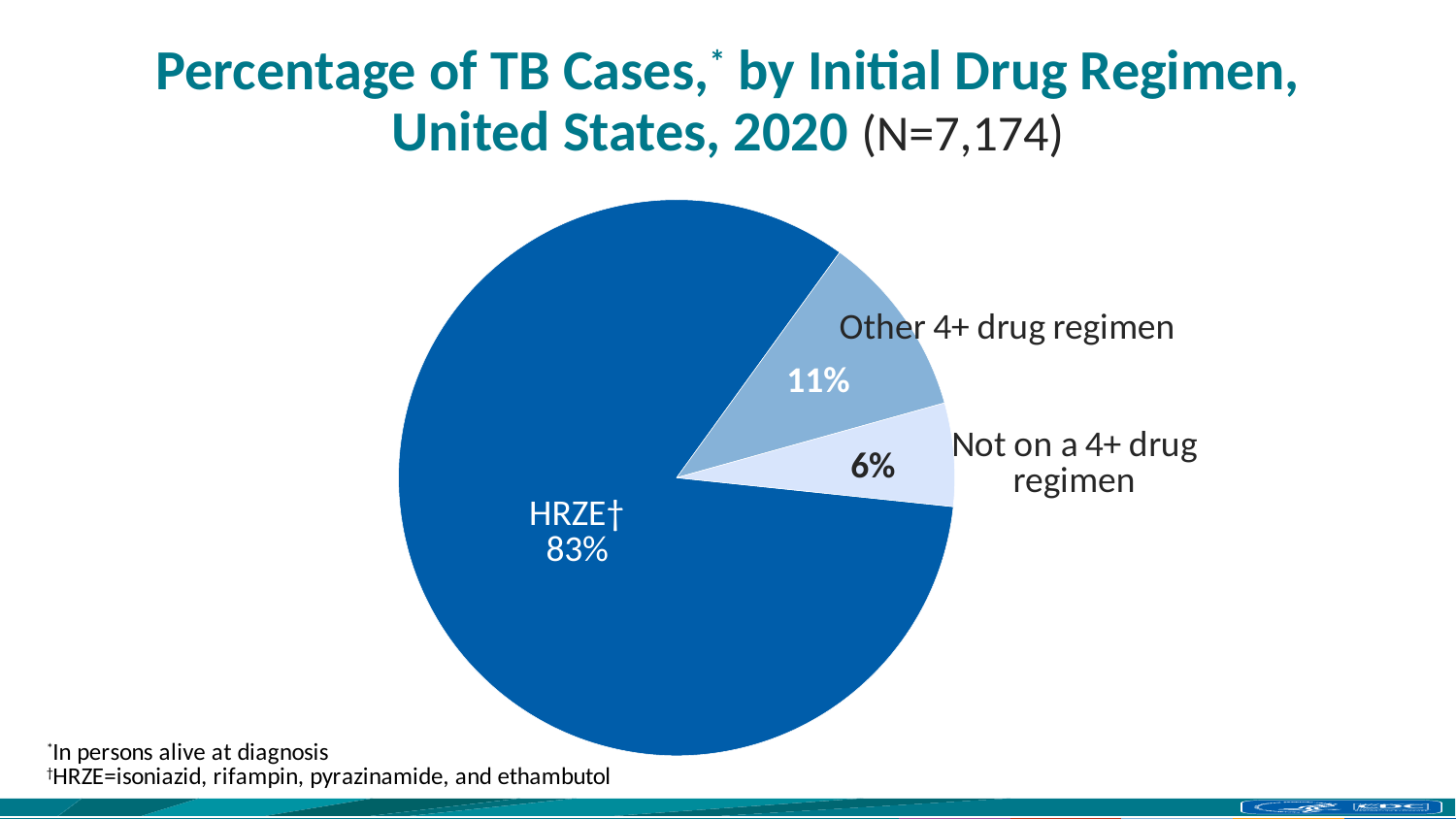
What type of chart is shown on the slide? Pie chart Which initial drug regimen category has the smallest share of TB cases? Not on a 4+ drug regimen What percentage of TB cases had HRZE as the initial drug regimen? 83% What is the total number of TB cases (N) shown in the chart title? 7,174 How many categories are shown in the pie chart? 3 What is the difference in percentage points between other 4+ drug regimen and not on a 4+ drug regimen? 5 Which initial drug regimen category has the largest share of TB cases? HRZE According to the footnote, what drugs does HRZE stand for? Isoniazid, rifampin, pyrazinamide, and ethambutol What percentage of TB cases were not on a 4+ drug regimen? 6% Which is larger: the share for other 4+ drug regimen or the share for not on a 4+ drug regimen? Other 4+ drug regimen What percentage of TB cases were on an other 4+ drug regimen? 11% What is the difference in percentage points between HRZE and other 4+ drug regimen? 72